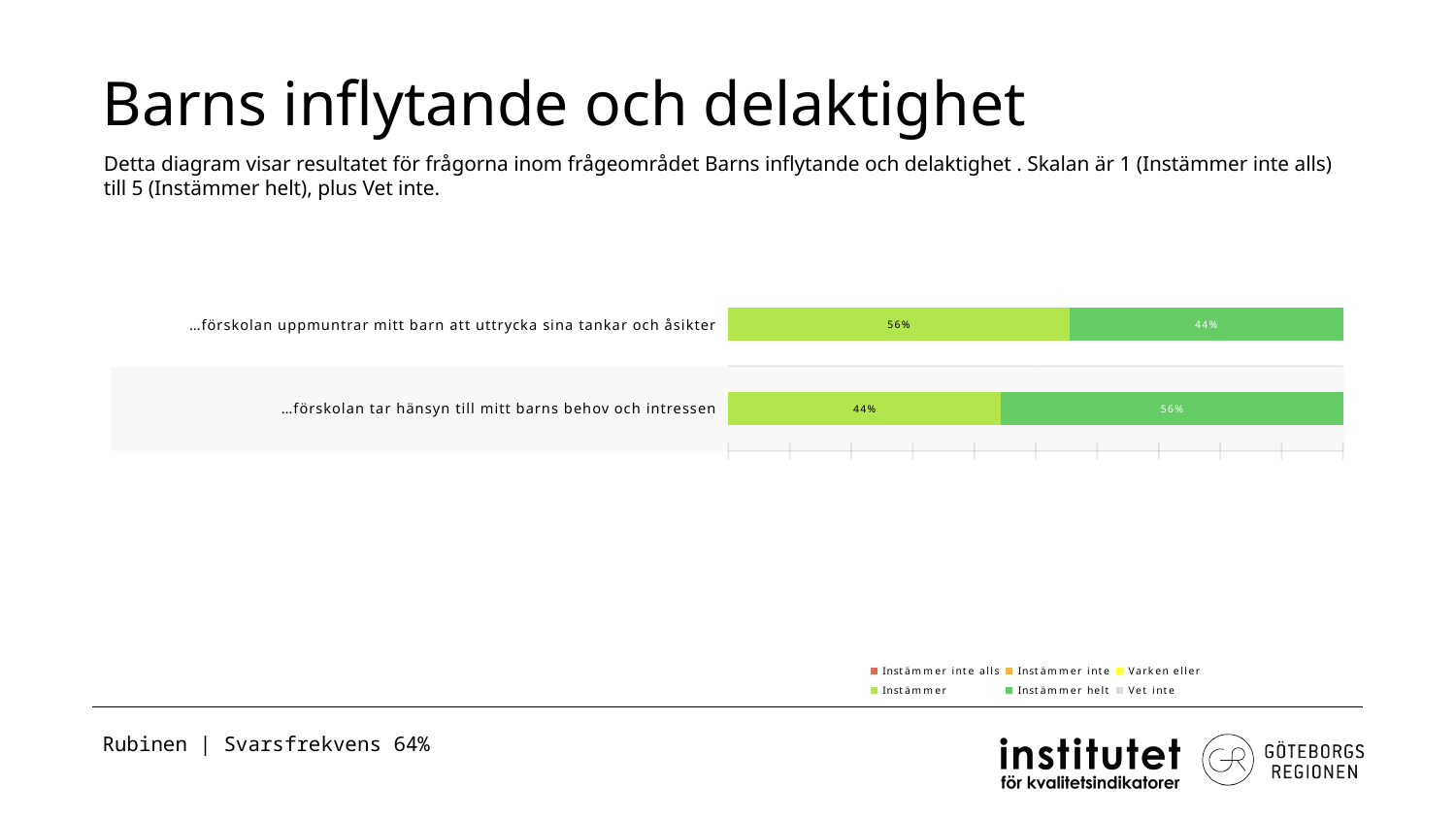
What is the difference between the "Instämmer" and "Instämmer helt" values for "…förskolan uppmuntrar mitt barn att uttrycka sina tankar och åsikter"? 12% How many categories (questions) are plotted in the chart? 2 What is the value of "Instämmer" for "…förskolan uppmuntrar mitt barn att uttrycka sina tankar och åsikter"? 56% What is the value of "Instämmer" for "…förskolan tar hänsyn till mitt barns behov och intressen"? 44% What is the title of the slide containing the chart? Barns inflytande och delaktighet What is the total of the labelled segments in the bar for "…förskolan tar hänsyn till mitt barns behov och intressen"? 100% Which category has the lower "Instämmer" share? …förskolan tar hänsyn till mitt barns behov och intressen What is the value of "Instämmer helt" for "…förskolan uppmuntrar mitt barn att uttrycka sina tankar och åsikter"? 44% What is the value of "Instämmer helt" for "…förskolan tar hänsyn till mitt barns behov och intressen"? 56% What kind of chart is shown on the slide? stacked bar chart How many series does the legend list? 6 Which category has the higher "Instämmer helt" share? …förskolan tar hänsyn till mitt barns behov och intressen